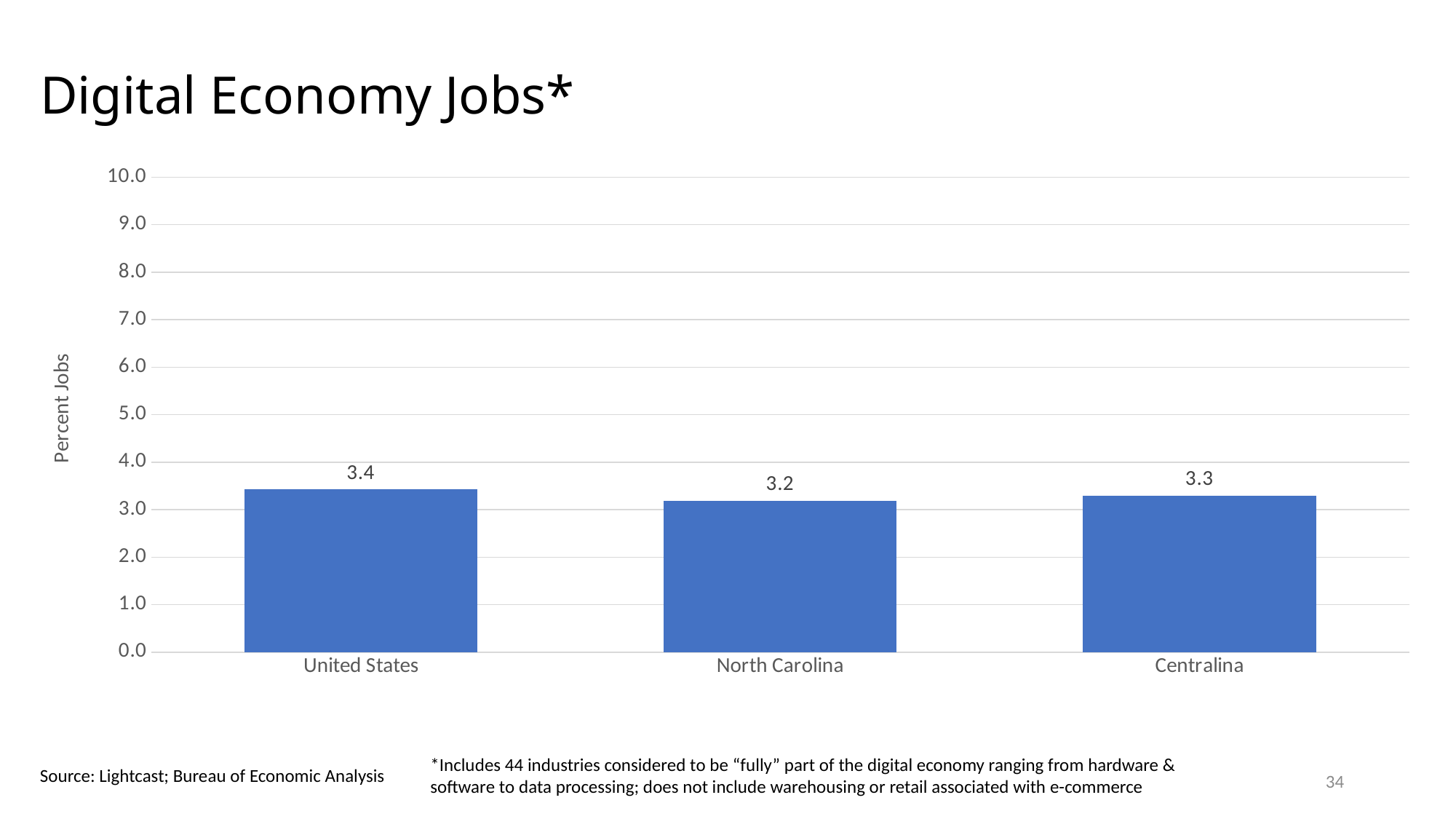
What is the value for United States? 3.4 How many categories are shown on the chart? 3 Which is larger, the value for United States or the value for Centralina? United States What is the difference between the values for Centralina and North Carolina? 0.1 What is the value for Centralina? 3.3 What is the label of the vertical axis? Percent Jobs Which category has the highest value? United States Which category has the lowest value? North Carolina Is the value for North Carolina greater or less than 4.0? less What kind of chart is shown on the slide? bar chart What is the value for North Carolina? 3.2 What is the difference between the values for United States and North Carolina? 0.2